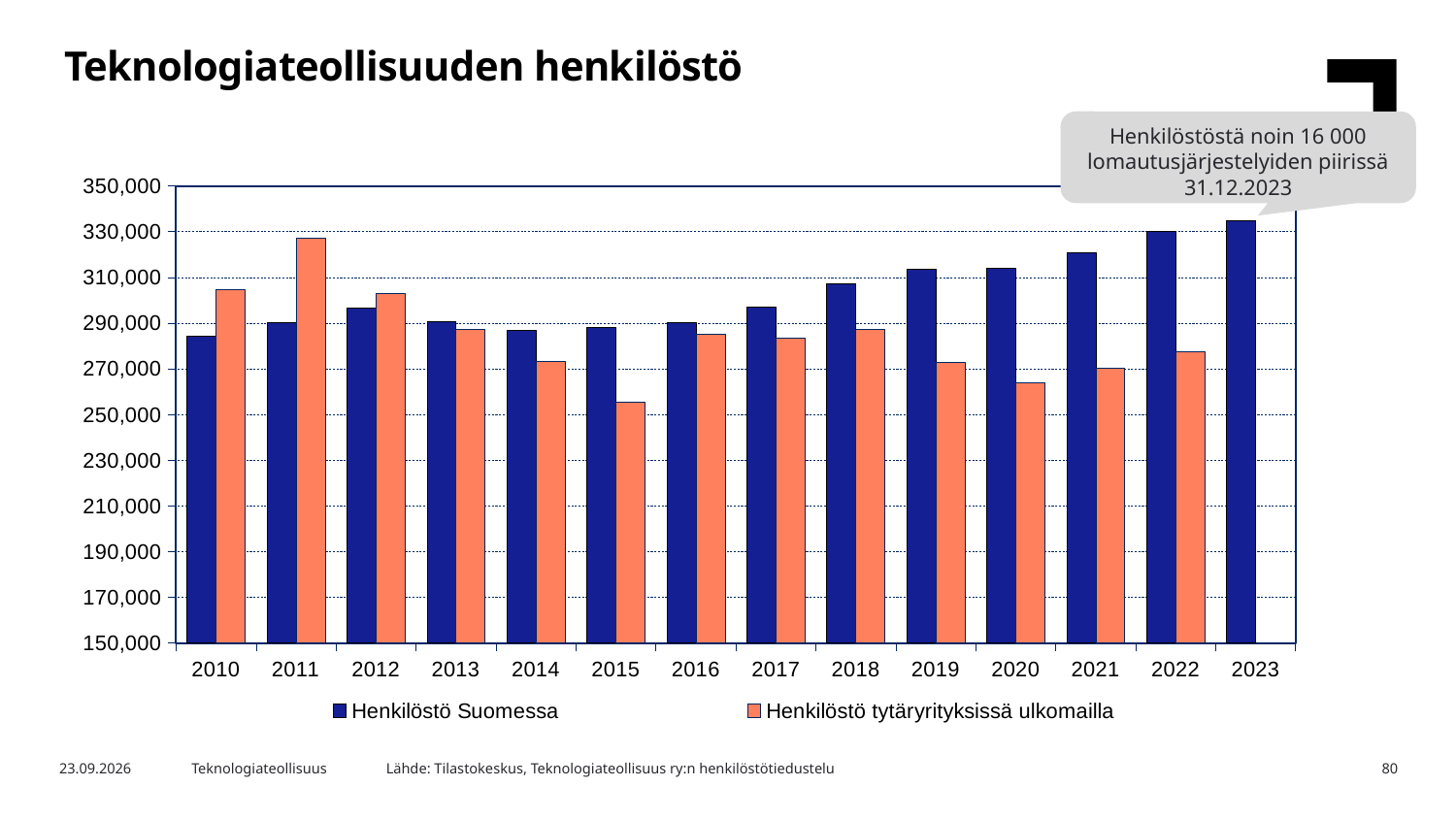
How many years are shown on the x axis? 14 Is the value for Henkilöstö tytäryrityksissä ulkomailla in 2015 greater or less than 270,000? less In which year is the value for Henkilöstö tytäryrityksissä ulkomailla lowest? 2015 In 2010, which series has the larger value: Henkilöstö Suomessa or Henkilöstö tytäryrityksissä ulkomailla? Henkilöstö tytäryrityksissä ulkomailla In which year is the value for Henkilöstö Suomessa highest? 2023 In which year is the value for Henkilöstö tytäryrityksissä ulkomailla highest? 2011 Does the value for Henkilöstö Suomessa rise or fall from 2017 to 2023? rise What kind of chart is shown on the slide? Bar chart In 2019, which series has the larger value: Henkilöstö Suomessa or Henkilöstö tytäryrityksissä ulkomailla? Henkilöstö Suomessa How many series does the legend list? 2 Is the value for Henkilöstö Suomessa in 2010 greater or less than 290,000? less Is the value for Henkilöstö Suomessa in 2023 greater or less than 310,000? greater